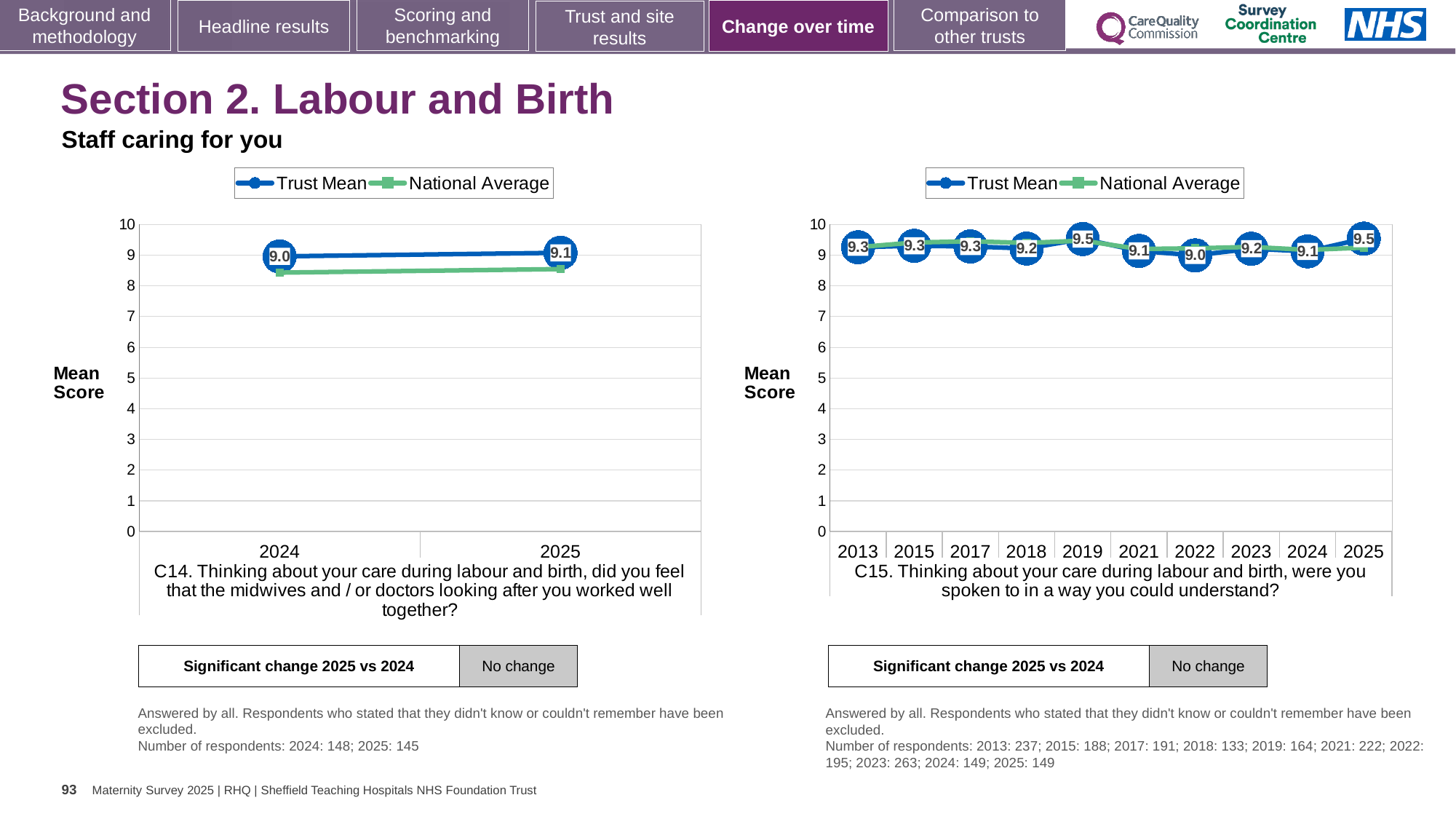
What kind of chart is the C15 chart on the right? line chart In the C14 chart on the left, does the Trust Mean rise or fall from 2024 to 2025? rise In the C15 chart on the right, what is the Trust Mean for 2019? 9.5 In the C15 chart on the right, which is larger: the Trust Mean for 2018 or the Trust Mean for 2021? 2018 In the C14 chart on the left, what is the Trust Mean for 2025? 9.1 In the C14 chart on the left, what is the Trust Mean for 2024? 9.0 How many years are shown on the x axis of the C15 chart on the right? 10 How many series does the legend of the C14 chart on the left list? 2 In the C15 chart on the right, what is the difference between the Trust Mean for 2025 and the Trust Mean for 2024? 0.4 In the C15 chart on the right, what is the Trust Mean for 2022? 9.0 In the C14 chart on the left, is the National Average for 2024 greater or less than 9? less In the C15 chart on the right, which year has the lowest Trust Mean? 2022